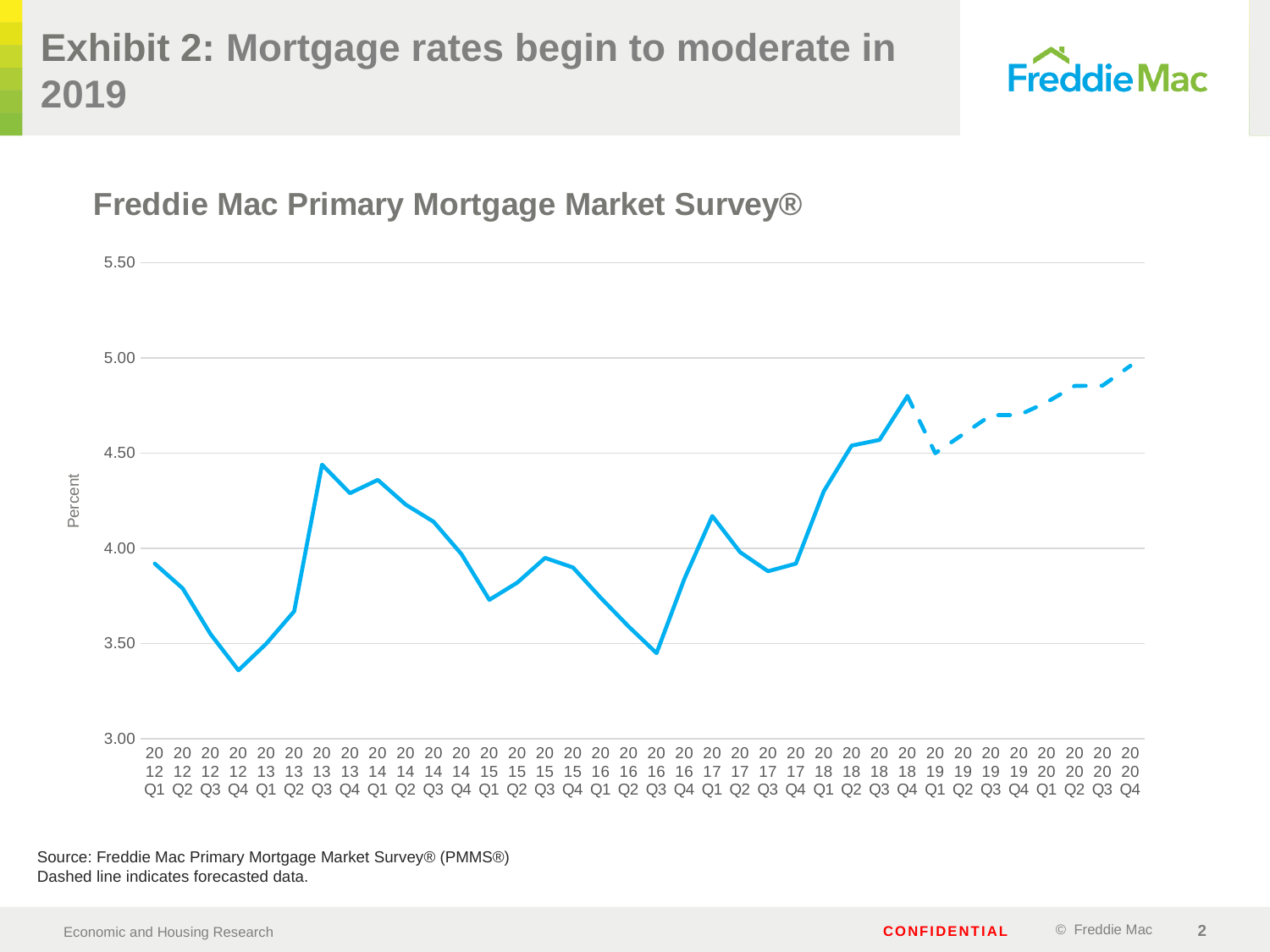
Which is larger, the value for 2013 Q3 or the value for 2016 Q3? 2013 Q3 Which quarter has the lowest mortgage rate on the chart? 2012 Q4 What kind of chart is shown on the slide? line chart Is the value for 2012 Q4 greater or less than 3.50? less How many quarterly data points are plotted on the chart? 36 Which quarter has the highest mortgage rate on the chart? 2020 Q4 What does the dashed portion of the line indicate? forecasted data Is the value for 2018 Q4 greater or less than 4.50? greater Is the value for 2020 Q4 greater or less than 5.00? less Do the values rise or fall from 2019 Q1 to 2020 Q4? rise